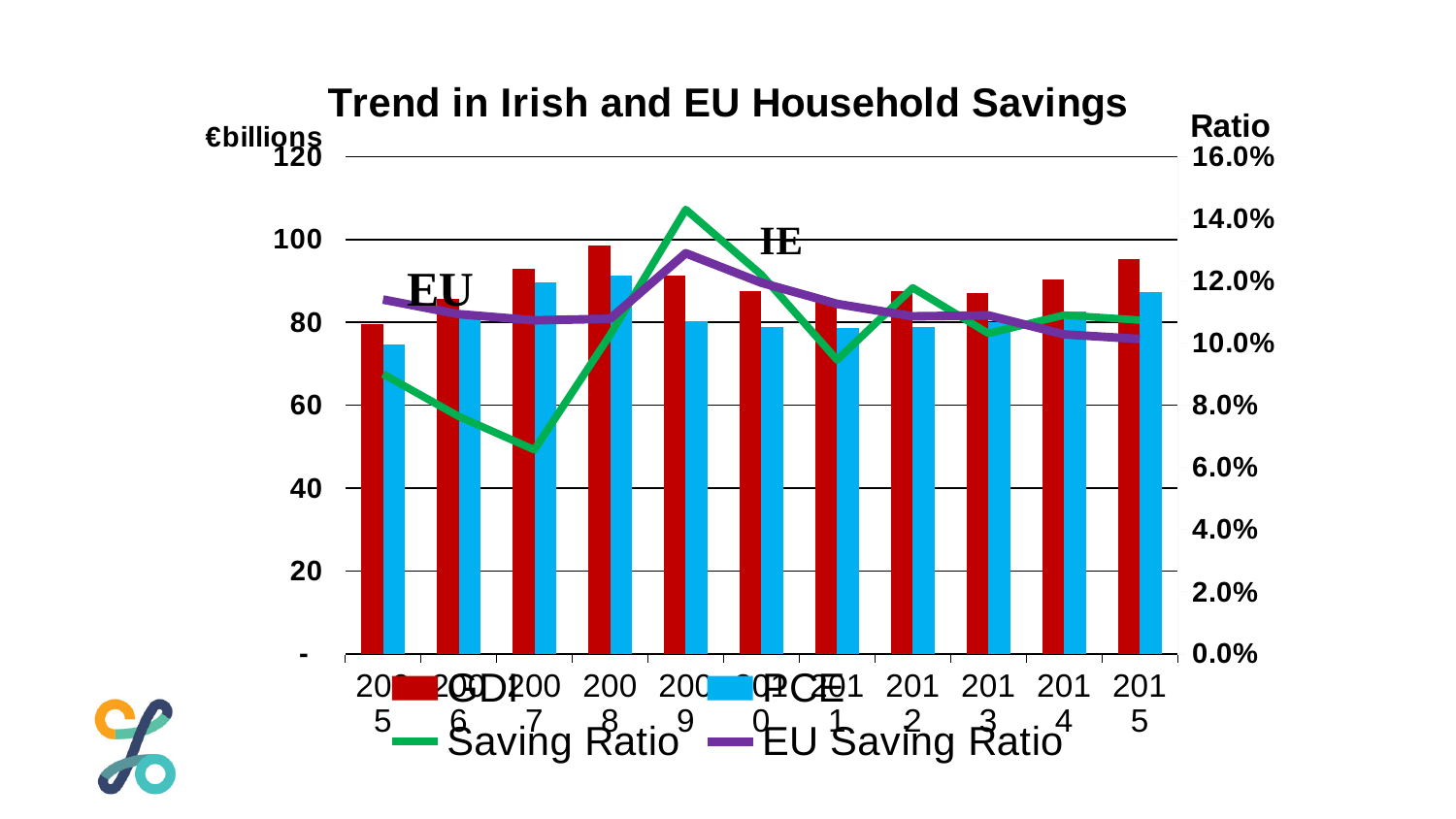
Does the EU Saving Ratio line rise or fall from 2009 to 2015? fall In which year is the Saving Ratio line at its highest? 2009 How many years are shown on the x axis? 11 Is the Saving Ratio for 2009 greater or less than 12.0%? greater What is the title of the chart? Trend in Irish and EU Household Savings In which year is the GDI bar the lowest? 2005 Is the GDI value for 2005 greater or less than 100? less What unit is shown on the left vertical axis? €billions What kind of chart is shown on the slide? A combined bar and line chart In which year is the Saving Ratio line at its lowest? 2007 In 2009, which is higher: the Saving Ratio or the EU Saving Ratio? Saving Ratio How many series does the legend list? 4